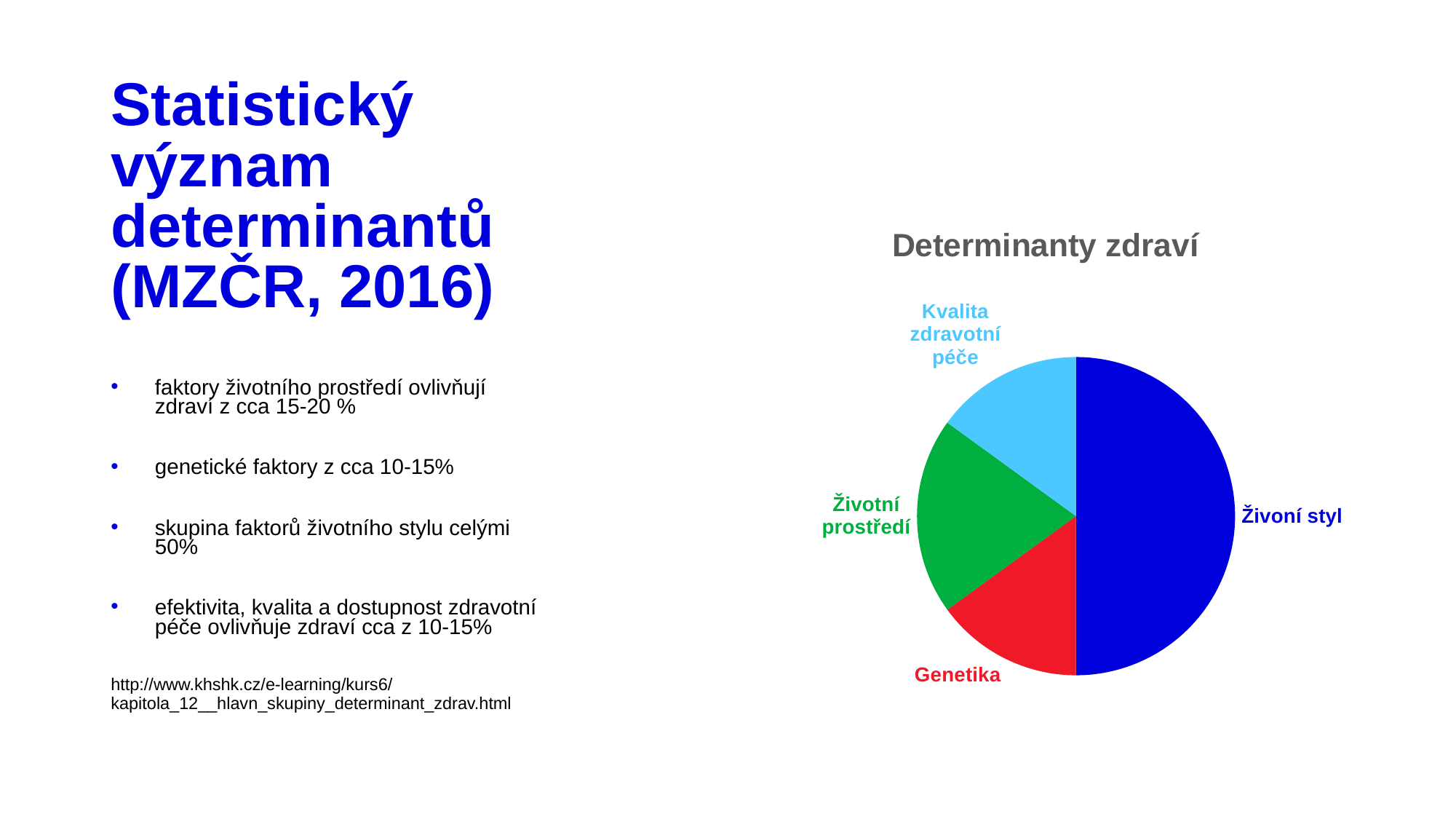
Which slice is larger in the pie chart, Živoní styl or Životní prostředí? Živoní styl Which category is shown in red in the pie chart? Genetika Which category has the largest slice in the pie chart? Živoní styl Which slice is larger in the pie chart, Živoní styl or Genetika? Živoní styl How many slices does the pie chart have? 4 What kind of chart is shown on the slide? pie chart What is the title of the chart on the slide? Determinanty zdraví Which slice is larger in the pie chart, Kvalita zdravotní péče or Živoní styl? Živoní styl